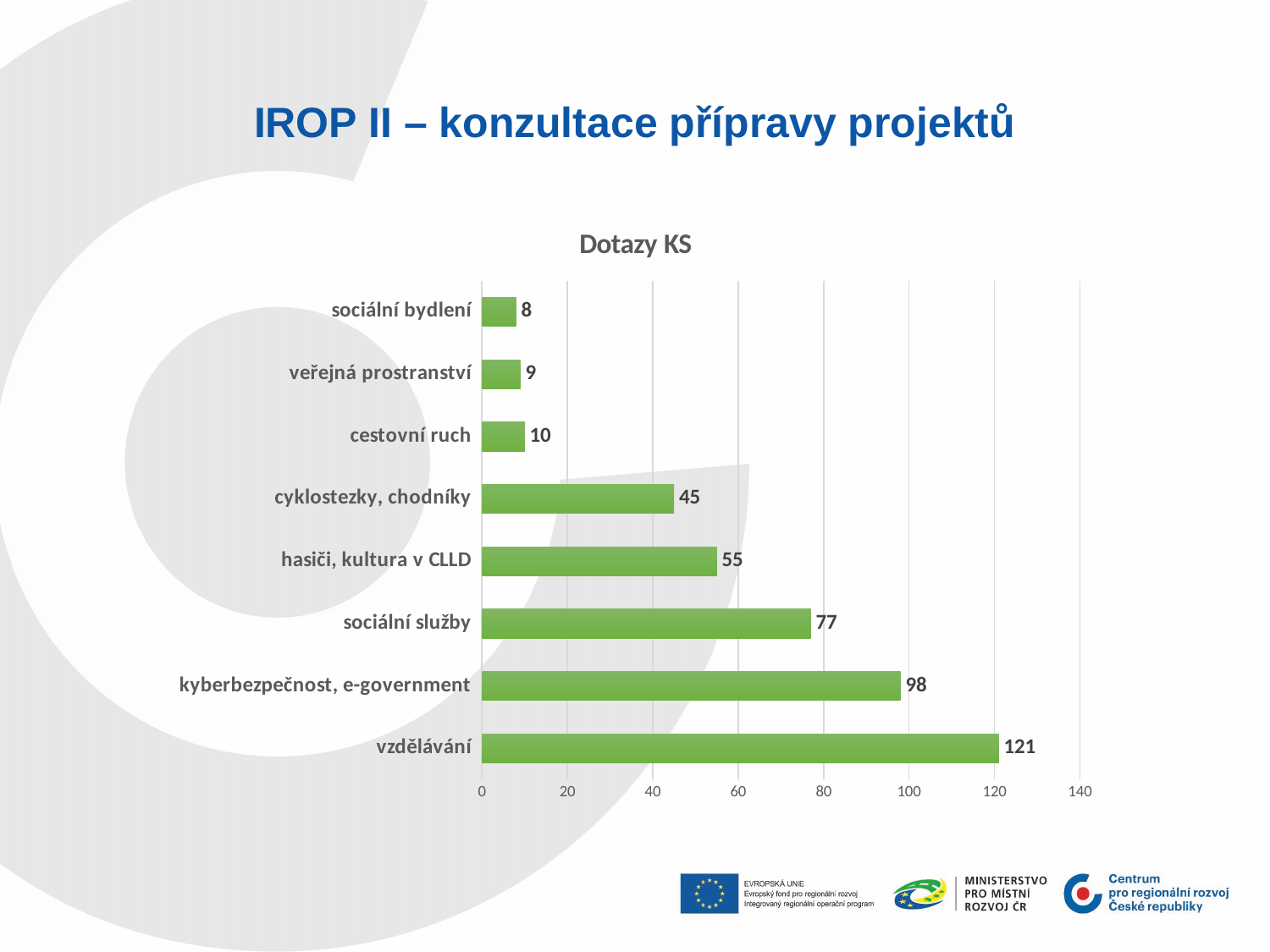
What is the difference between the values for vzdělávání and kyberbezpečnost, e-government? 23 What kind of chart is shown on the slide? bar chart What is the value for kyberbezpečnost, e-government? 98 What is the title of the chart? Dotazy KS Which category has the highest value? vzdělávání What is the value for hasiči, kultura v CLLD? 55 Is the value for kyberbezpečnost, e-government greater or less than 100? less Which is larger, the value for sociální služby or the value for hasiči, kultura v CLLD? sociální služby What is the difference between the values for sociální služby and cyklostezky, chodníky? 32 What is the value for vzdělávání? 121 How many categories are shown in the chart? 8 Which category has the lowest value? sociální bydlení